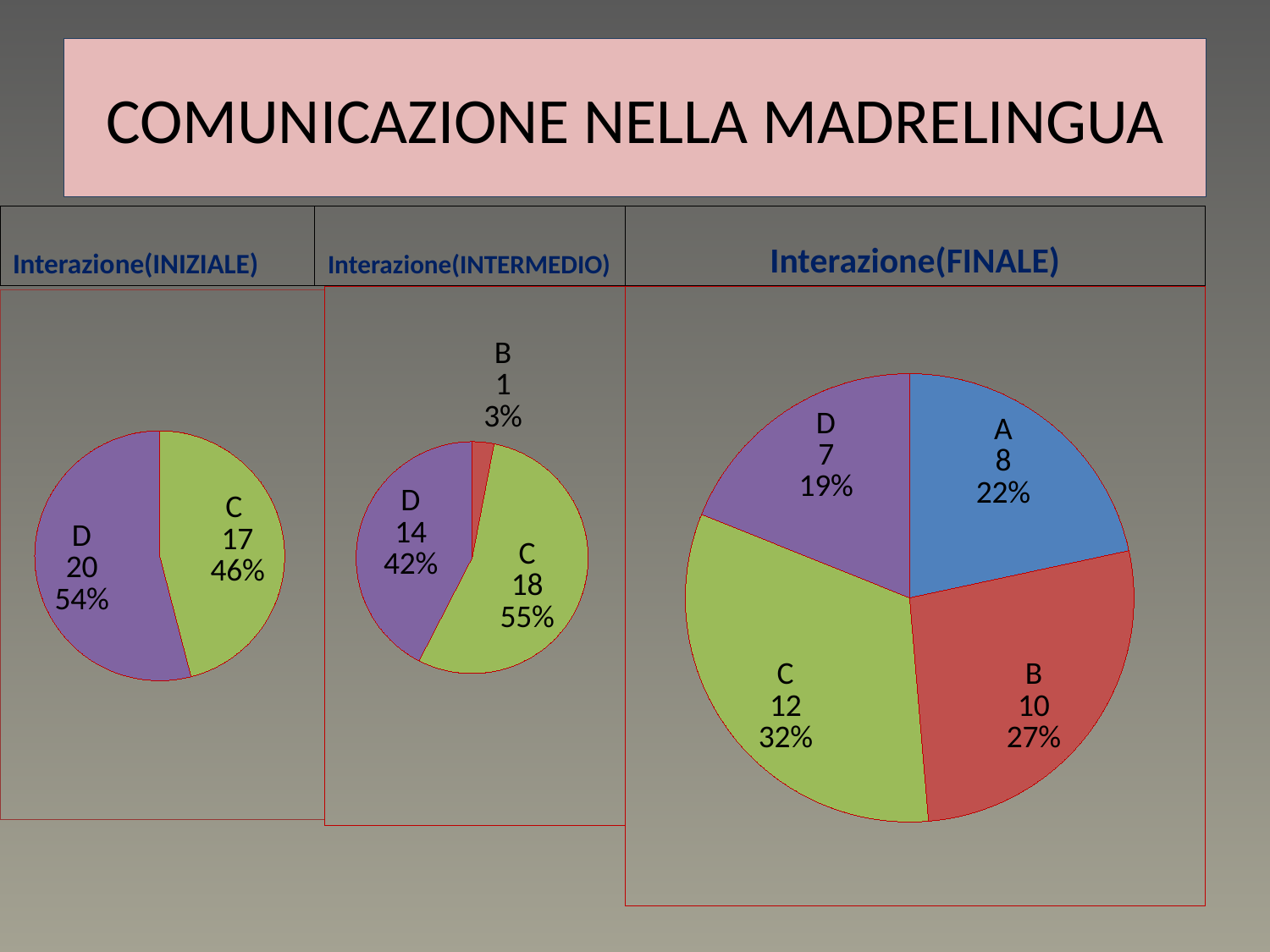
In the Interazione(FINALE) chart, what value is shown for category A? 8 What type of chart is the Interazione(INIZIALE) chart? Pie chart In the Interazione(INTERMEDIO) chart, what value is shown for category B? 1 In the Interazione(INIZIALE) chart, what share of the pie does category C have? 46% In the Interazione(FINALE) chart, which category has the smallest slice? D In the Interazione(FINALE) chart, what is the difference between the values for C and B? 2 In the Interazione(INTERMEDIO) chart, what share of the pie does category D have? 42% In the Interazione(INTERMEDIO) chart, which category has the largest slice? C In the Interazione(FINALE) chart, how many categories are shown? 4 In the Interazione(FINALE) chart, what colour is the slice for category A? Blue In the Interazione(INIZIALE) chart, what value is shown for category D? 20 In the Interazione(FINALE) chart, which is larger, the value for B or the value for D? B